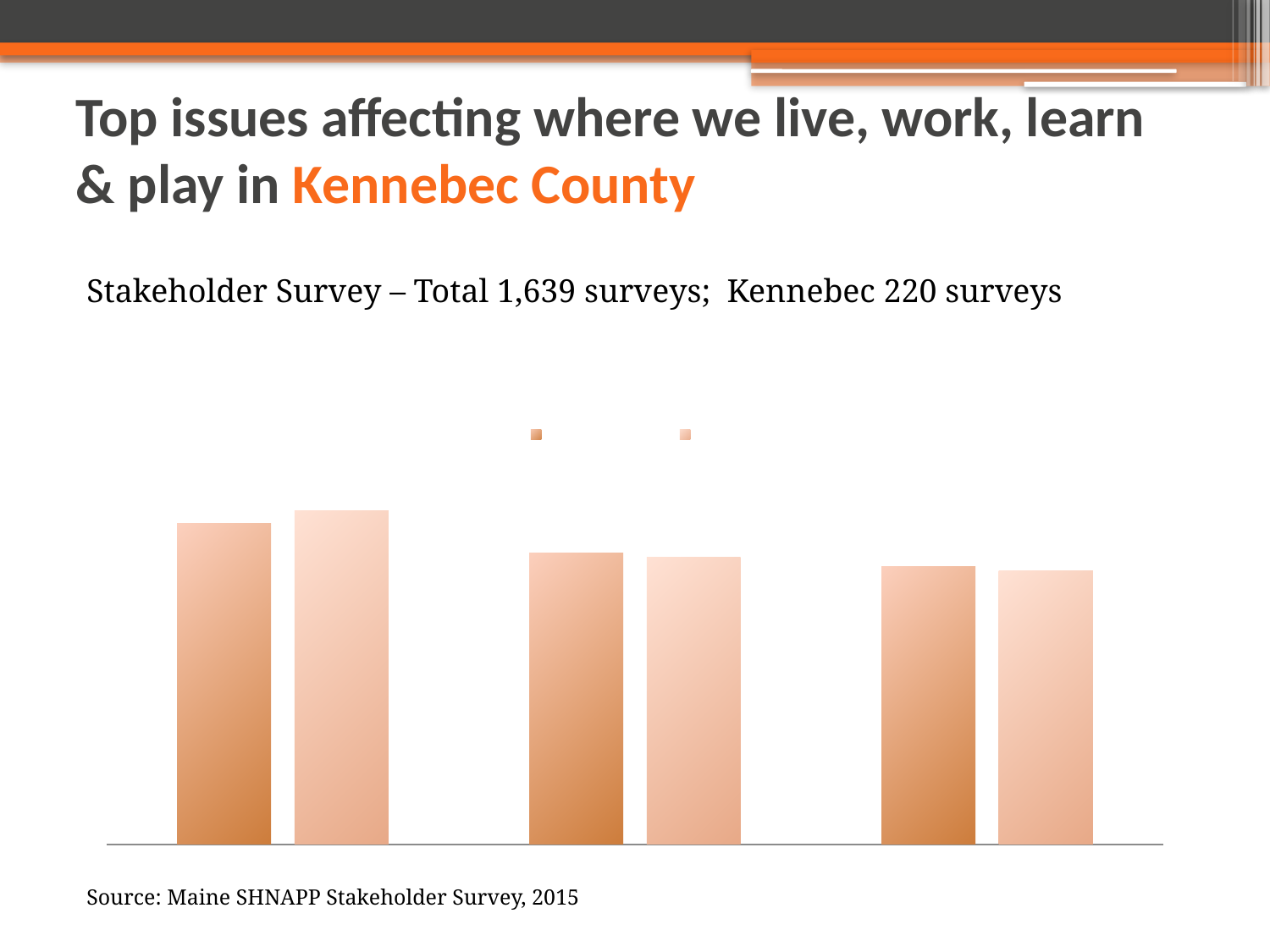
How many groups of bars are plotted on the chart? 3 How many series does the legend list? 2 What kind of chart is shown on the slide? bar chart How many bars in total are plotted on the chart? 6 Are the bars on the chart vertical or horizontal? vertical Do the bar heights rise or fall from left to right across the chart? fall